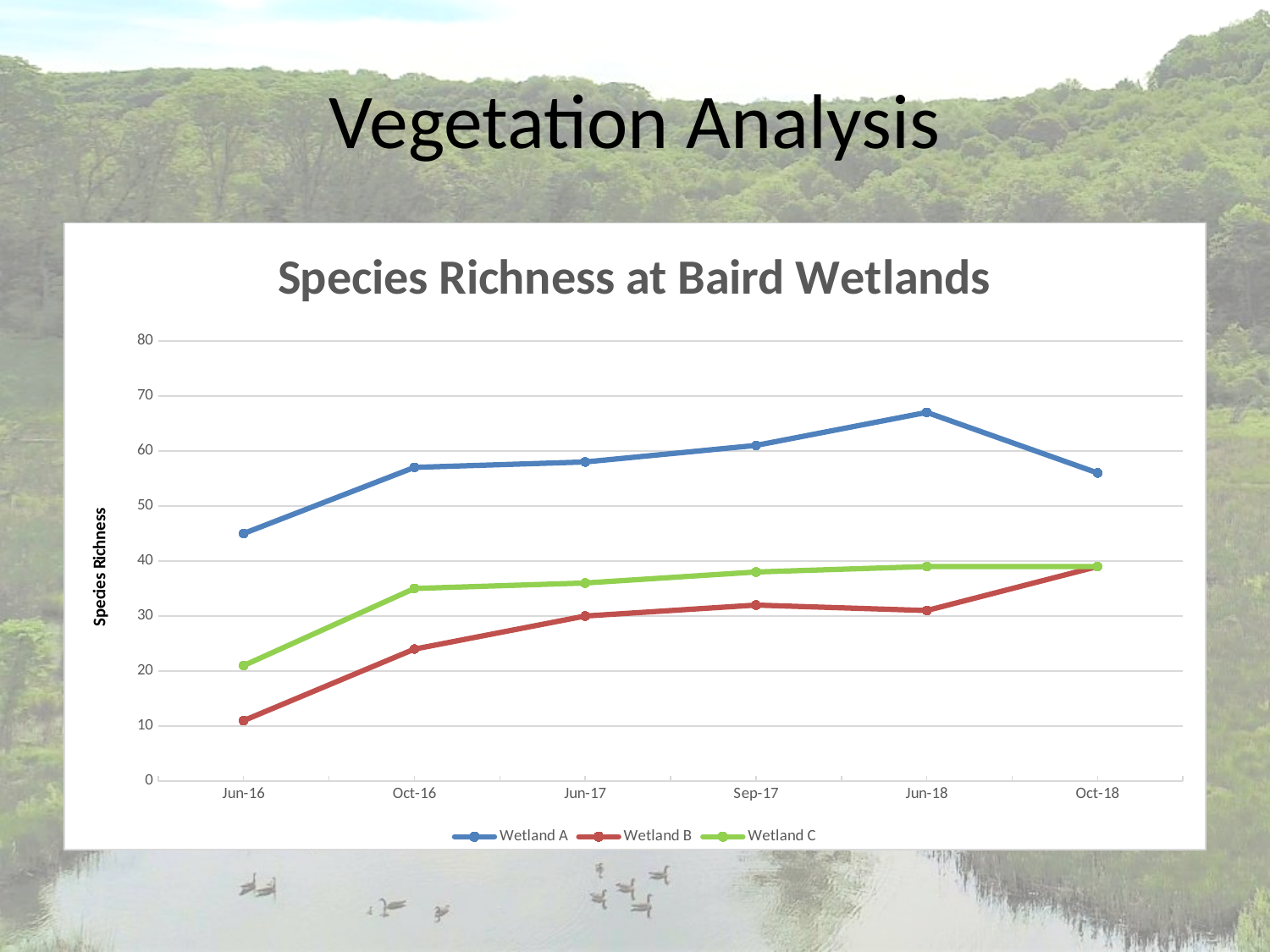
How many time points are shown along the x axis? 6 At Oct-16, which has the higher species richness, Wetland B or Wetland C? Wetland C Does the Wetland C line generally rise or fall from Jun-16 to Oct-18? Rise At which time point does Wetland B have its lowest species richness? Jun-16 At Jun-16, which has the higher species richness, Wetland A or Wetland C? Wetland A Is the value for Wetland A at Jun-18 greater or less than 60? greater Is the value for Wetland B at Jun-16 greater or less than 20? less What is the title of the chart? Species Richness at Baird Wetlands What kind of chart is shown on the slide? Line chart How many series does the legend list? 3 At which time point does Wetland A reach its highest species richness? Jun-18 Is the value for Wetland C at Oct-16 greater or less than 30? greater